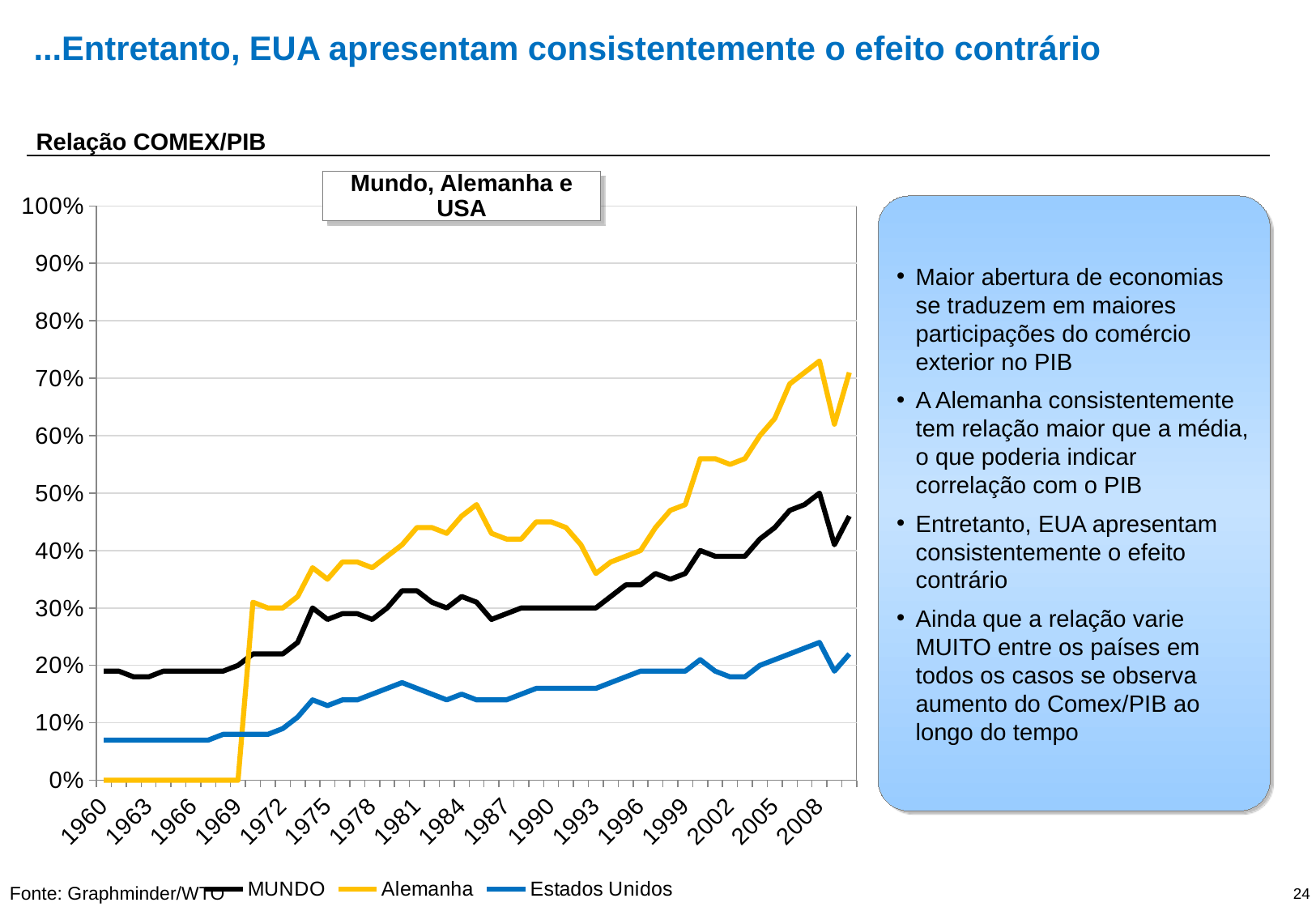
In 2005, which is larger: the value for Alemanha or the value for Estados Unidos? Alemanha Is the value for Alemanha in 2008 greater or less than 60%? greater What are the three series named in the legend? MUNDO, Alemanha, Estados Unidos Which series has the highest value in 2008? Alemanha What is the title shown inside the chart area? Mundo, Alemanha e USA Is the value for Estados Unidos in 1960 greater or less than 10%? less Which series has the lowest value in 2008? Estados Unidos What kind of chart is shown on the slide? line chart Does the Estados Unidos series generally rise or fall from 1960 to 2008? rise What value is plotted for Alemanha in 1960? 0% Is the value for MUNDO in 1990 greater or less than 40%? less How many series does the legend list? 3